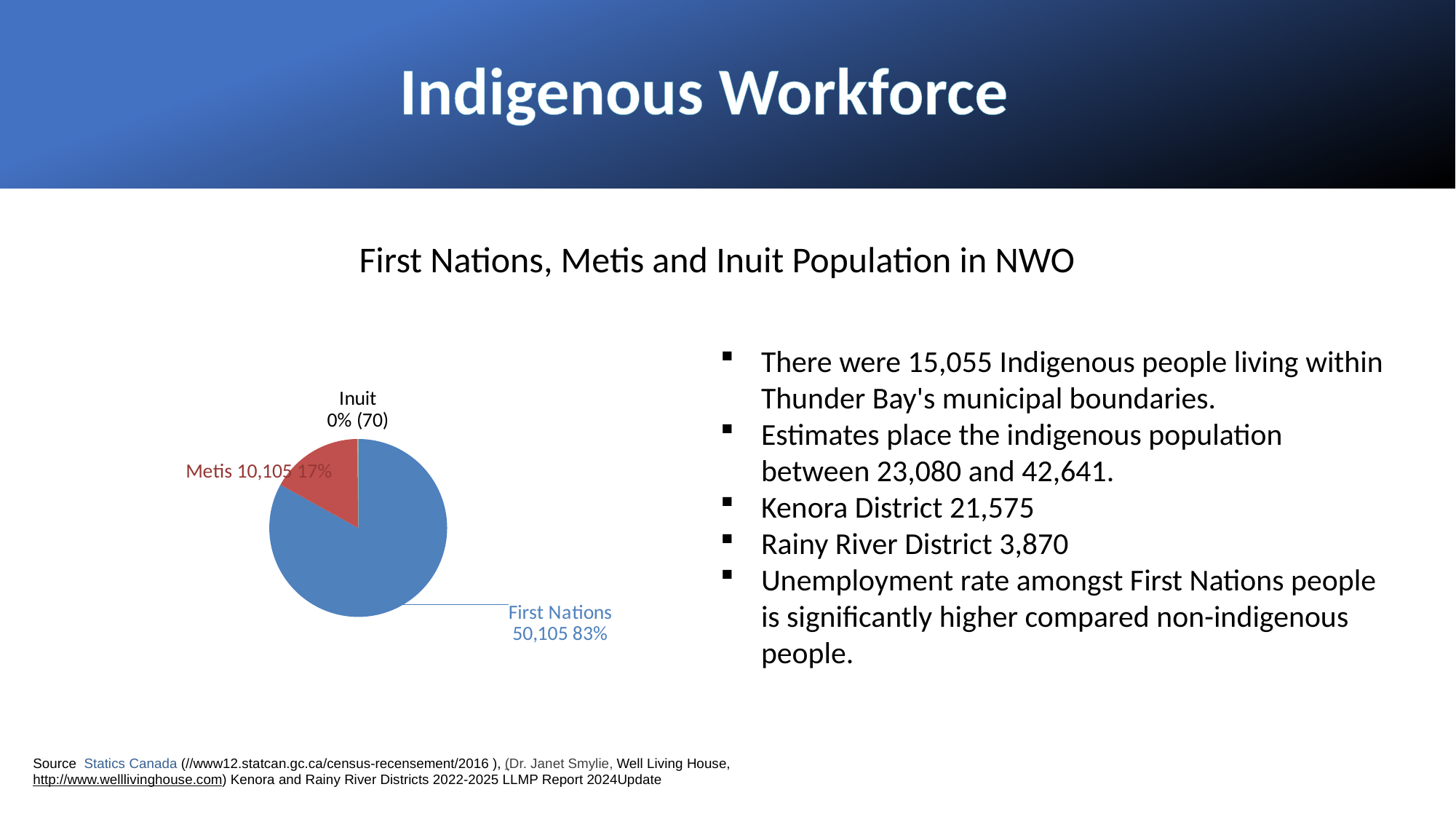
What is the population value shown for Inuit? 70 What is the difference between the First Nations and Metis population values? 40,000 What is the population value shown for First Nations? 50,105 What is the title of the chart? First Nations, Metis and Inuit Population in NWO Which group has the smallest slice of the pie? Inuit What is the population value shown for Metis? 10,105 Which group has the largest slice of the pie? First Nations How many slices does the pie chart have? 3 What kind of chart is shown on the slide? pie chart What percentage share of the pie does Metis represent? 17% What percentage share of the pie does First Nations represent? 83% Which is larger, the Metis population or the Inuit population? Metis